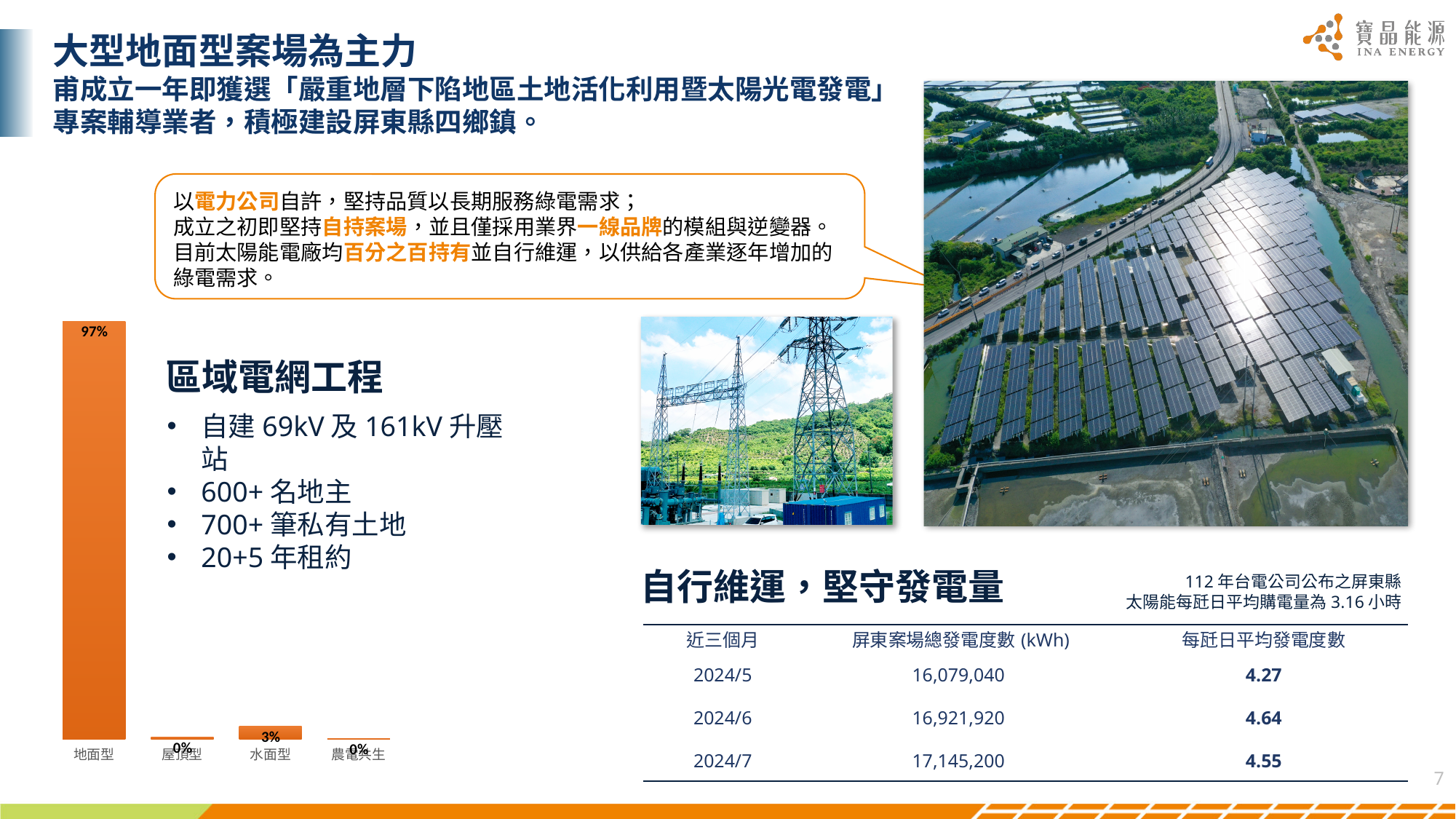
In the bar chart on the left, which is larger, 地面型 or 水面型? 地面型 In the bar chart on the left, what is the value for 水面型? 3% In the bar chart on the left, which category is shown first (leftmost)? 地面型 In the bar chart on the left, which two categories share the same value of 0%? 屋頂型 and 農電共生 What colour are the bars in the bar chart on the left? orange In the bar chart on the left, what is the value for 屋頂型? 0% What kind of chart is shown on the left of the slide? bar chart In the bar chart on the left, what is the value for 農電共生? 0% In the bar chart on the left, what is the difference between the values for 地面型 and 水面型? 94 percentage points How many categories does the bar chart on the left show? 4 In the bar chart on the left, what is the value for 地面型? 97% Which category has the highest value in the bar chart on the left? 地面型